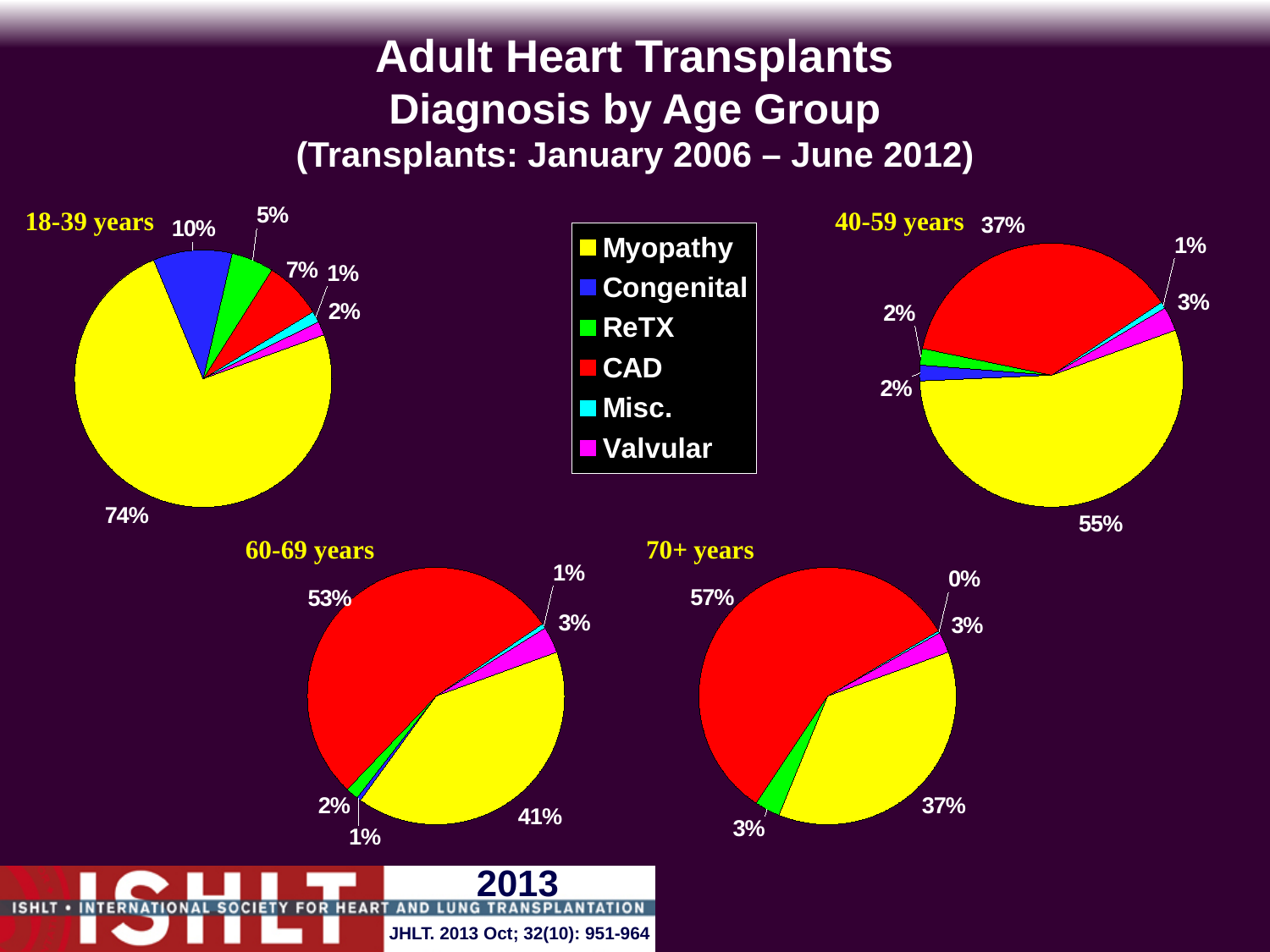
In the 70+ years pie chart, what share of transplants is for CAD? 57% What type of chart is used to show diagnosis by age group on this slide? Pie chart In the 60-69 years pie chart, what is the difference between the CAD share and the Myopathy share? 12% In the 18-39 years pie chart, what share of transplants is for Congenital diagnosis? 10% In the 40-59 years pie chart, which diagnosis has the largest share? Myopathy In the 70+ years pie chart, which diagnosis has the largest share? CAD In the 18-39 years pie chart, which diagnosis has the smallest share? Misc. In the 18-39 years pie chart, what share of transplants is for Myopathy? 74% In the 40-59 years pie chart, what share of transplants is for CAD? 37% How many diagnosis categories does the legend list? 6 In the 60-69 years pie chart, what share of transplants is for Myopathy? 41% In the 40-59 years pie chart, which is larger, the Myopathy share or the CAD share? Myopathy